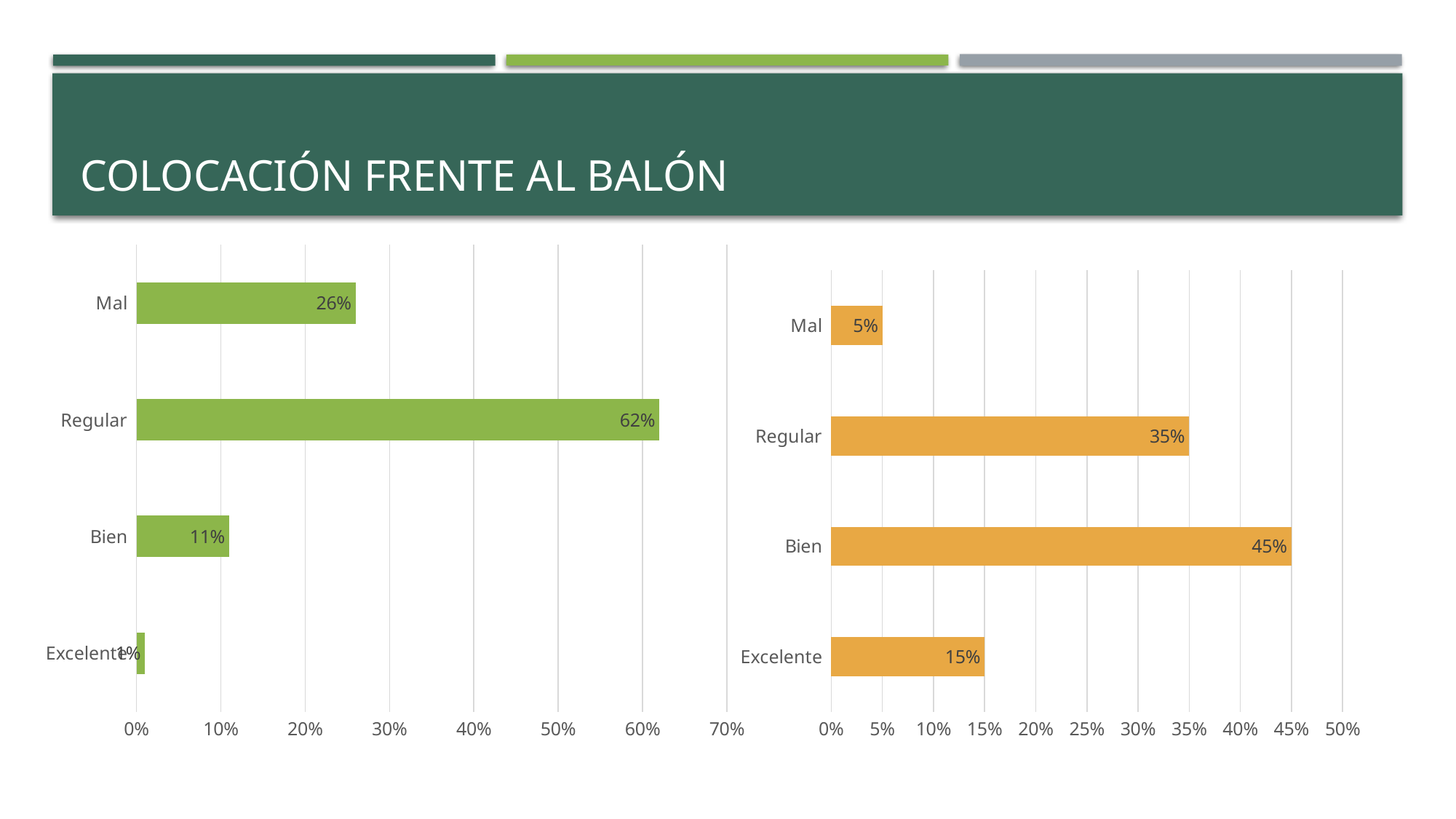
In the right chart, which category has the lowest value? Mal In the left chart, what is the value for Regular? 62% In the left chart, which category has the highest value? Regular In the left chart, is the value for Excelente greater or less than 10%? less In the right chart, what is the difference between Bien and Regular? 10% In the right chart, what is the value for Bien? 45% In the right chart, what is the value for Excelente? 15% In the right chart, which is larger, Regular or Excelente? Regular In the left chart, what is the value for Mal? 26% What kind of chart is the left chart? bar chart In the left chart, what is the difference between Mal and Bien? 15% How many categories does the right chart show? 4